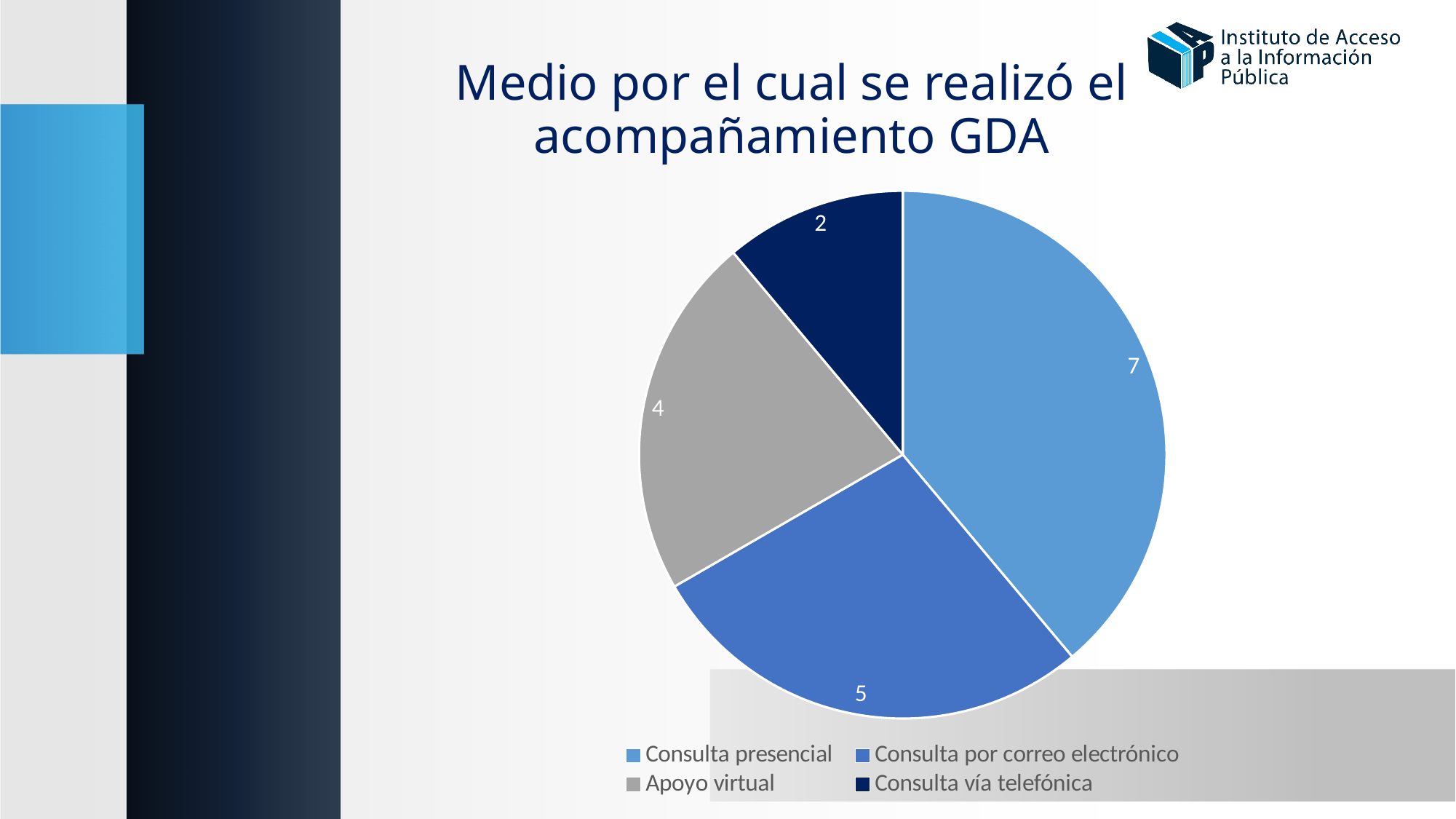
Which category has the largest slice of the pie? Consulta presencial What is the value for Apoyo virtual? 4 What type of chart is shown on the slide? Pie chart What is the value for Consulta por correo electrónico? 5 What is the total of all the slices in the pie chart? 18 What is the title of the chart? Medio por el cual se realizó el acompañamiento GDA Which is larger, the value for Consulta por correo electrónico or the value for Consulta vía telefónica? Consulta por correo electrónico Which category has the smallest slice of the pie? Consulta vía telefónica What is the difference between the values for Consulta presencial and Apoyo virtual? 3 How many categories does the pie chart have? 4 What is the value for Consulta presencial? 7 What is the value for Consulta vía telefónica? 2